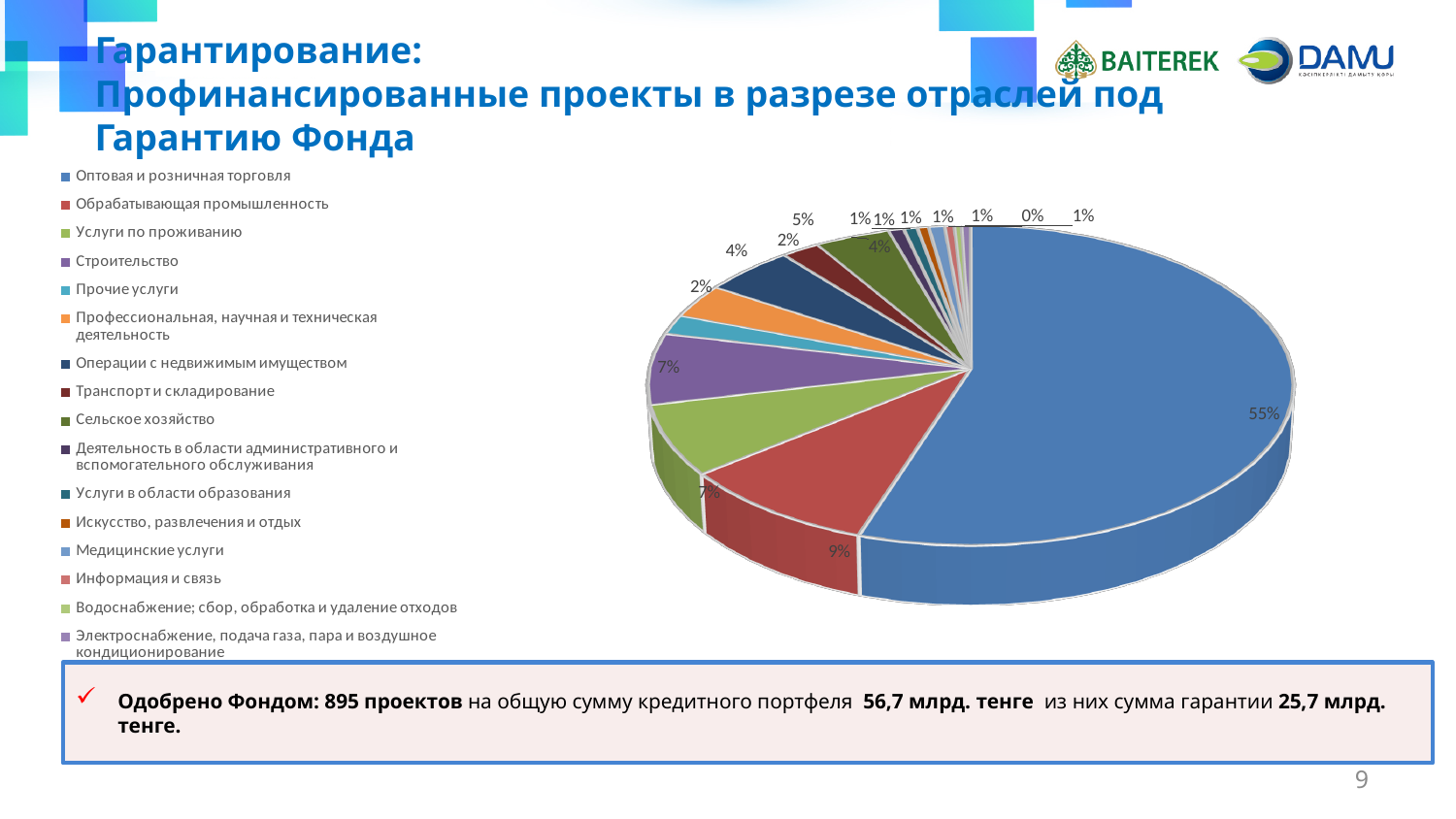
What is the smallest percentage label shown on the pie chart? 0% What share of the pie does Услуги по проживанию have? 7% Which category has the largest share of the pie chart? Оптовая и розничная торговля What kind of chart is shown on the slide? pie chart What is the title of the slide containing the pie chart? Гарантирование: Профинансированные проекты в разрезе отраслей под Гарантию Фонда What is the difference in percentage points between the shares of Оптовая и розничная торговля and Обрабатывающая промышленность? 46 percentage points What share of the pie does Операции с недвижимым имуществом have? 5% What share of the pie does Обрабатывающая промышленность have? 9% Is the share for Оптовая и розничная торговля greater or less than 50%? greater How many categories does the legend of the pie chart list? 16 Which has a larger share: Обрабатывающая промышленность or Строительство? Обрабатывающая промышленность